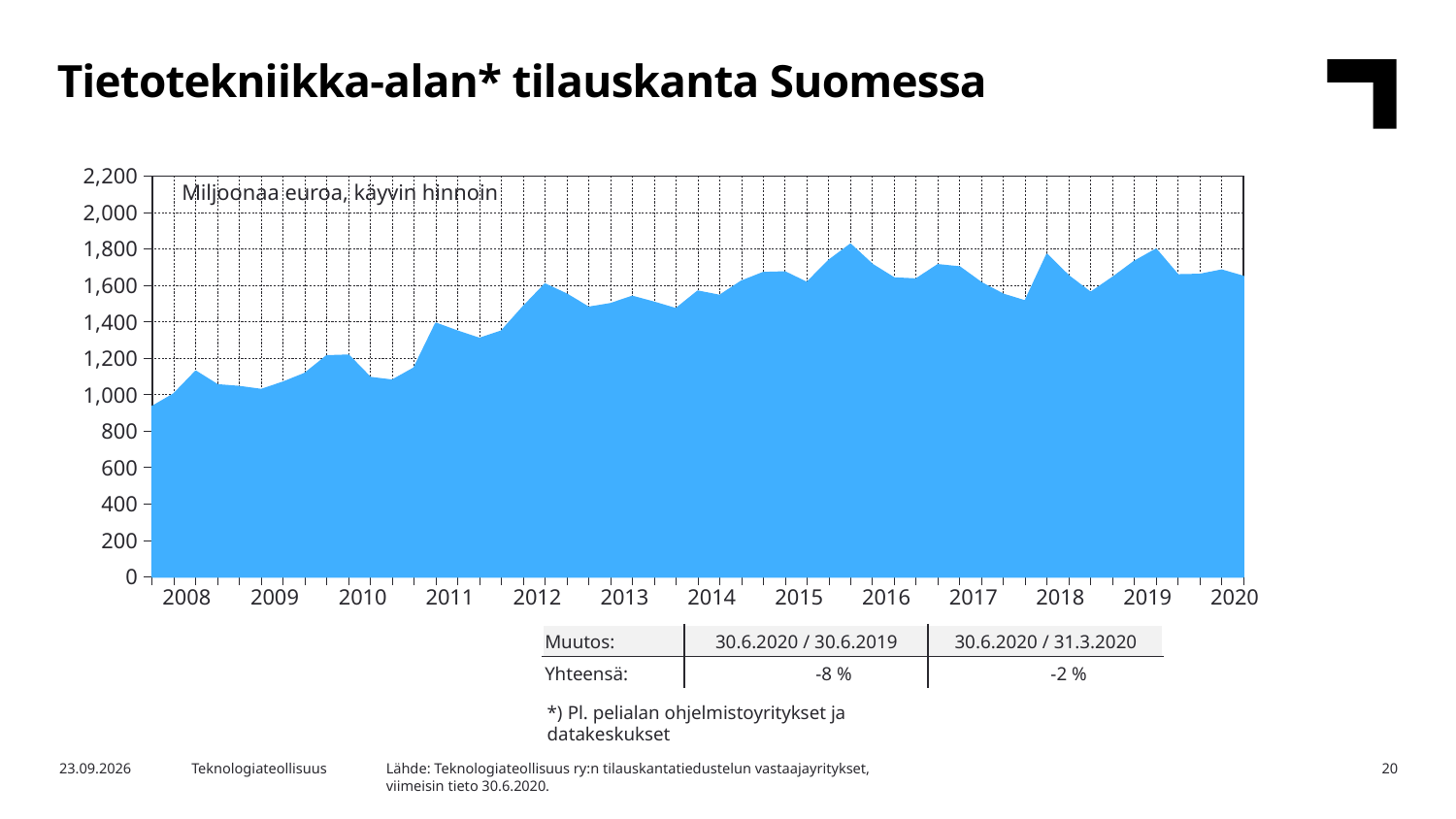
How many year labels are shown on the x axis? 13 What unit is stated in the label inside the chart area? Miljoonaa euroa, käyvin hinnoin Overall, does the order backlog rise or fall from 2008 to 2020? rise Is the value at the 2020 tick greater or less than 1,400? greater Is the highest point of the series, around 2015–2016, greater or less than 1,600? greater In which year does the series reach its lowest value? 2008 Is the value at the 2020 tick larger or smaller than the value at the 2008 tick? larger Is the value at the start of 2008 greater or less than 1,000? less What kind of chart is shown on the slide? Area chart What is the title of the chart on the slide? Tietotekniikka-alan* tilauskanta Suomessa